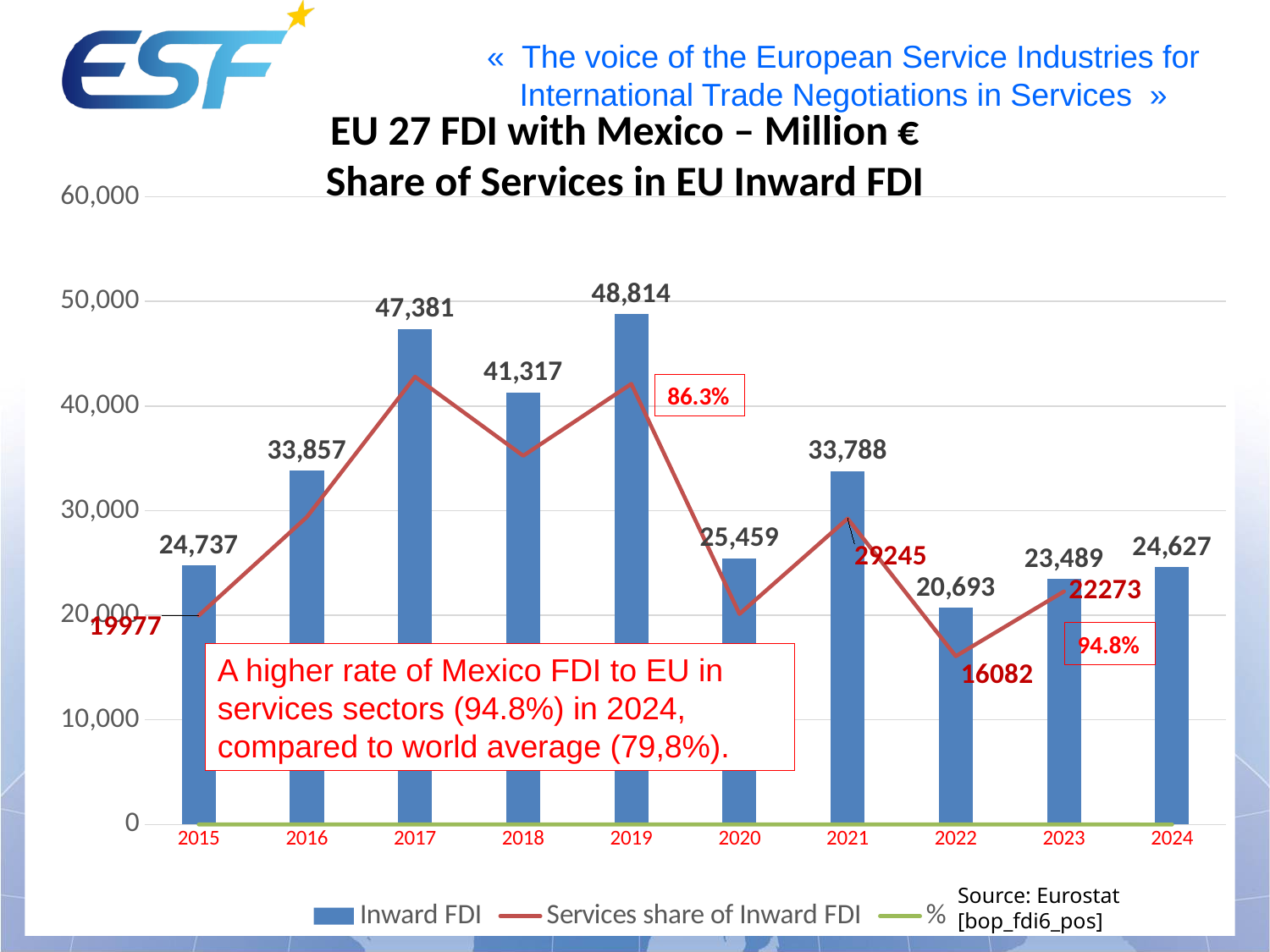
What is the Services share of Inward FDI value labelled for 2022? 16082 What is the difference between the Inward FDI values for 2019 and 2017? 1,433 How many series does the legend list? 3 Does Inward FDI rise or fall from 2019 to 2022? fall Which year has the highest Inward FDI? 2019 What is the Inward FDI value for 2015? 24,737 Which year has the larger Inward FDI, 2018 or 2020? 2018 What is the difference between the Inward FDI values for 2023 and 2022? 2,796 What kind of chart is shown? bar and line chart Which year has the lowest Inward FDI? 2022 What is the Inward FDI value for 2019? 48,814 How many years are shown on the x axis? 10